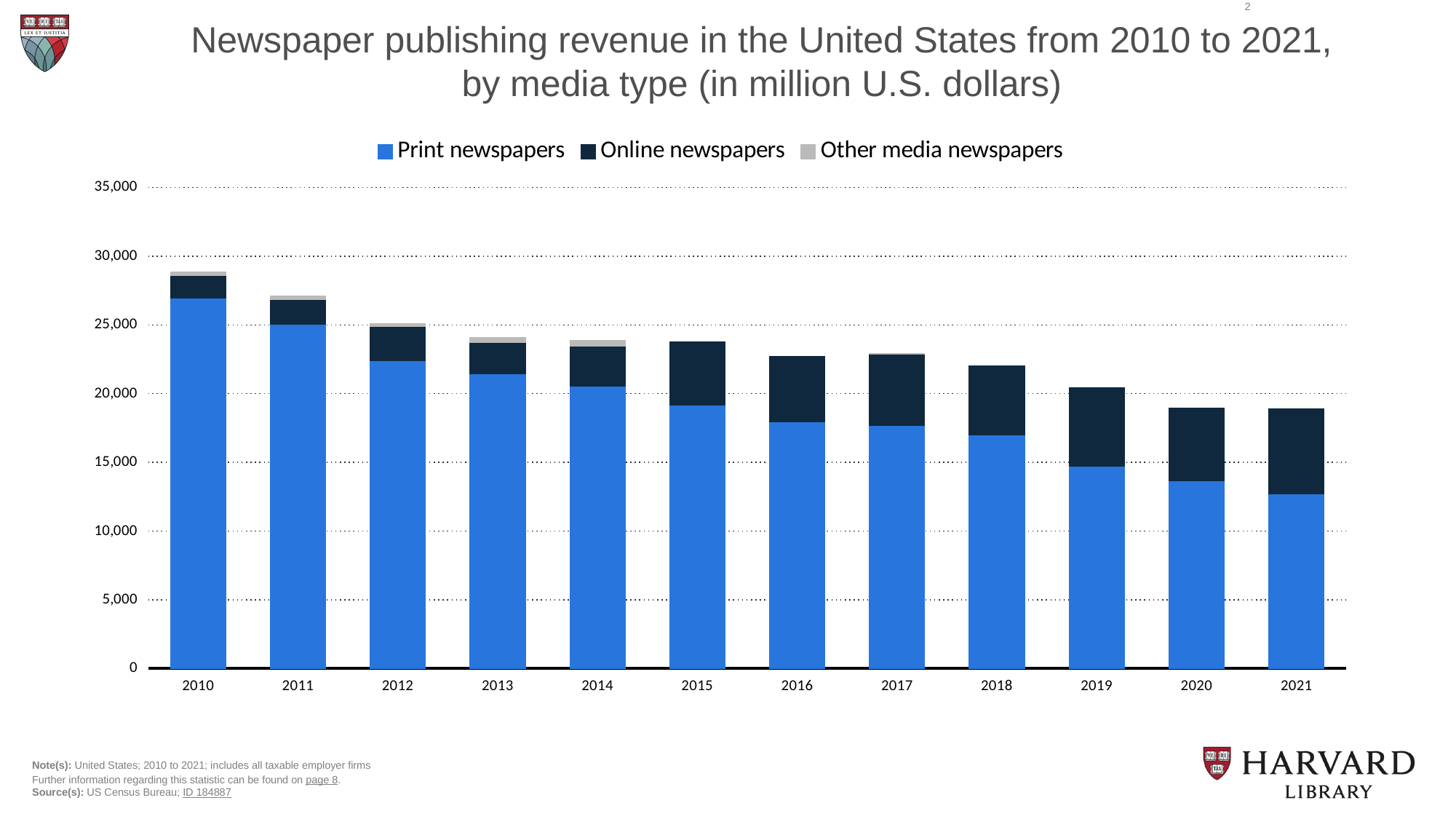
Is the Print newspapers value for 2021 greater or less than 15,000? less What kind of chart is shown on the slide? Stacked bar chart Is the total stacked bar for 2010 greater or less than 30,000? less Is the Print newspapers value for 2010 greater or less than 25,000? greater Which is larger: the Online newspapers segment in 2010 or in 2021? 2021 Which year has the highest total newspaper publishing revenue? 2010 How many years are shown along the x axis? 12 How many series does the legend list? 3 Does the total newspaper publishing revenue generally rise or fall from 2010 to 2021? Fall Which year has the highest Print newspapers revenue? 2010 Which series is shown in light blue in the legend? Print newspapers